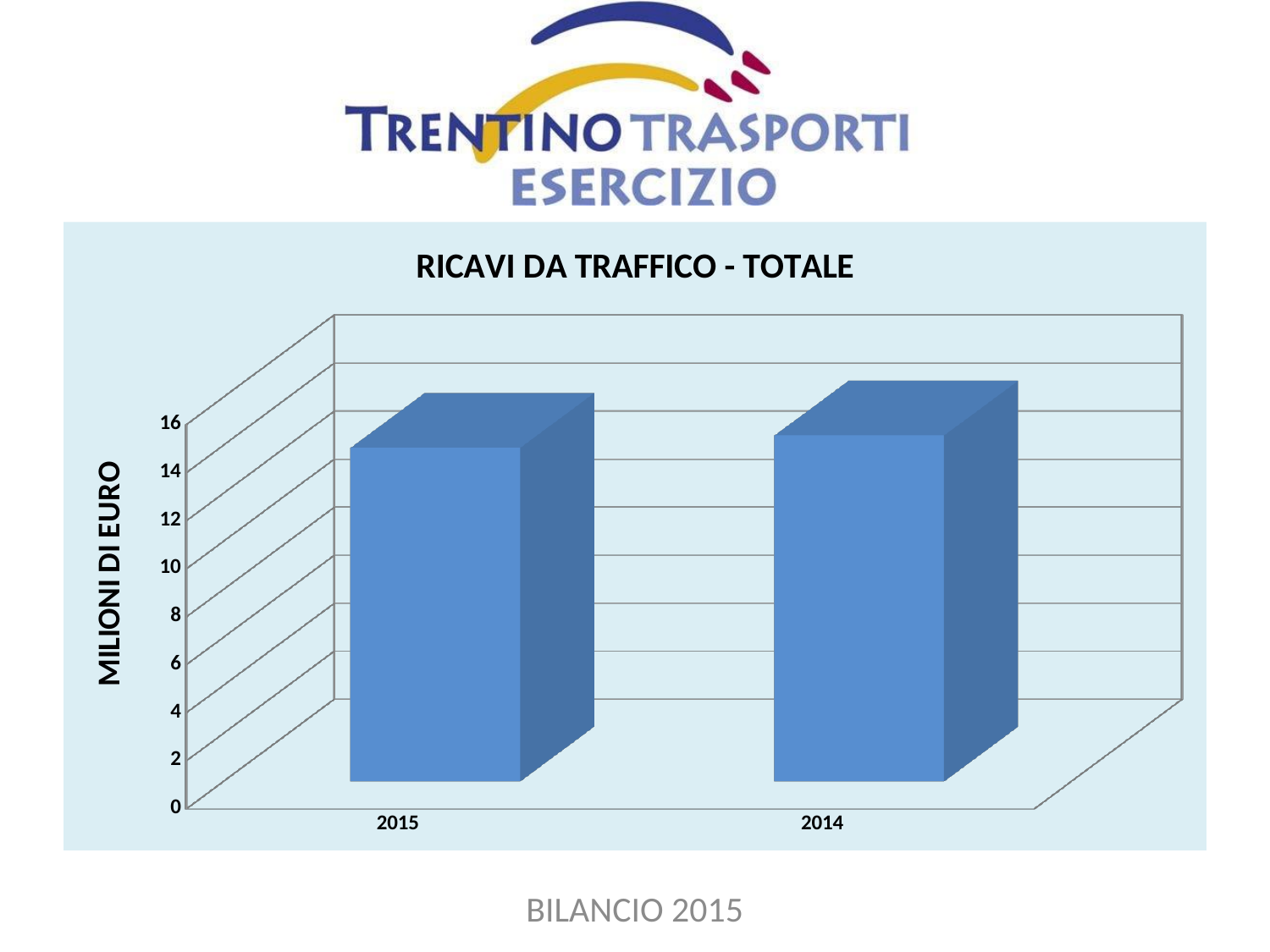
What is the label of the vertical axis of the chart? MILIONI DI EURO What is the highest value shown on the vertical axis of the chart? 16 Is the value for 2014 greater or less than 8? greater How many categories are plotted on the x axis of the chart? 2 Is the value for 2015 greater or less than 16? less What is the title of the chart? RICAVI DA TRAFFICO - TOTALE Which category has the lowest value in the chart? 2015 What kind of chart is shown on the slide? bar chart Is the value for 2015 greater or less than 10? greater Which year has the higher value in the chart, 2015 or 2014? 2014